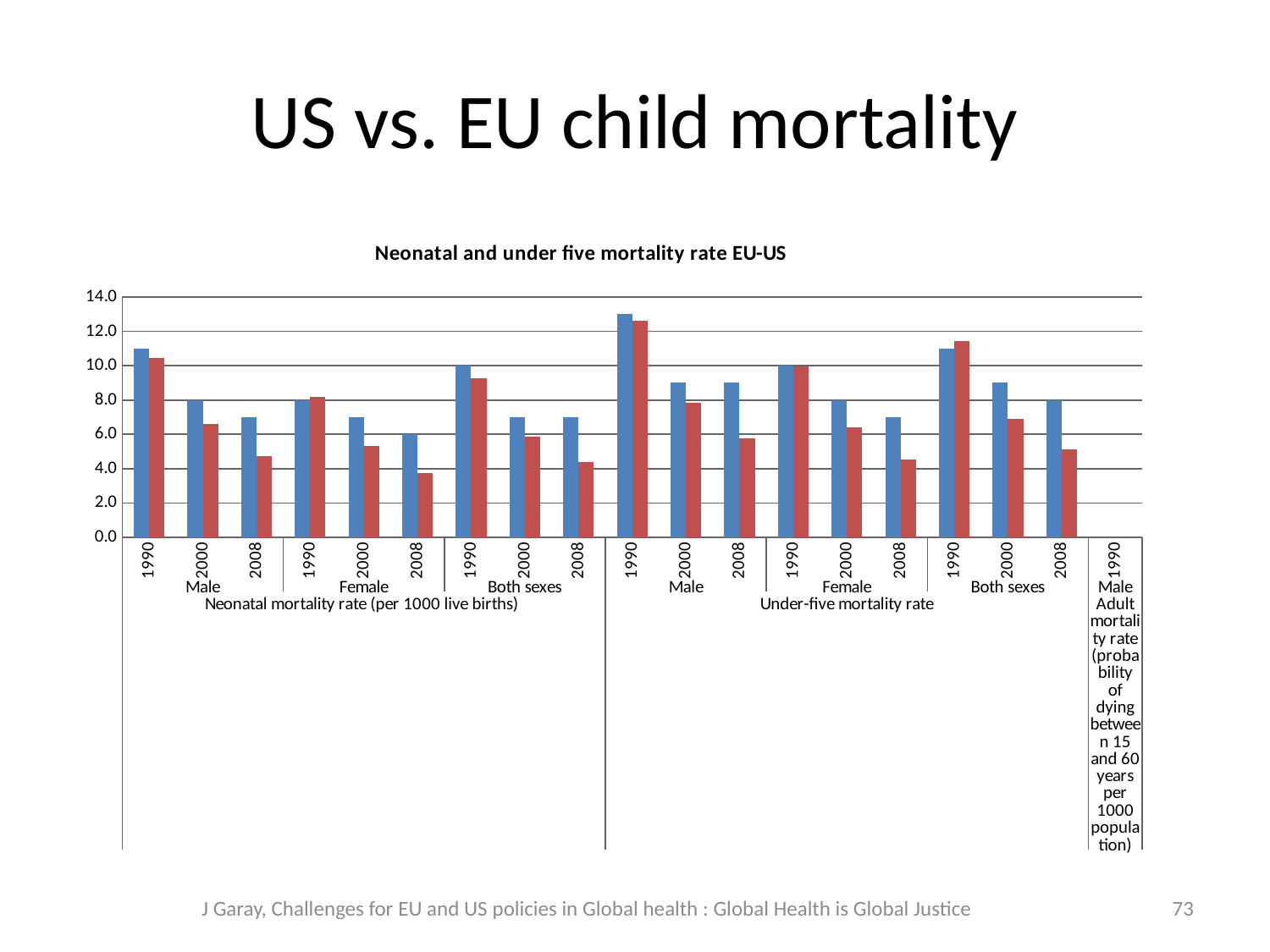
What is the highest value shown on the vertical axis? 14.0 Is the red bar for Neonatal mortality rate, Male, 2008 greater or less than 6.0? less Is the blue bar for Under-five mortality rate, Male, 1990 greater or less than 12.0? greater Is the red bar for Under-five mortality rate, Both sexes, 1990 greater or less than 10.0? greater What is the title of the chart? Neonatal and under five mortality rate EU-US For Neonatal mortality rate, Male, do the blue bars rise or fall from 1990 to 2008? fall Which group has the tallest blue bar in the chart? Under-five mortality rate, Male, 1990 What kind of chart is shown on the slide? bar chart Which group has the shortest red bar in the chart? Neonatal mortality rate, Female, 2008 How many differently coloured bar series are plotted in the chart? 2 For Under-five mortality rate, Male, 2008, which bar is taller, the blue one or the red one? blue